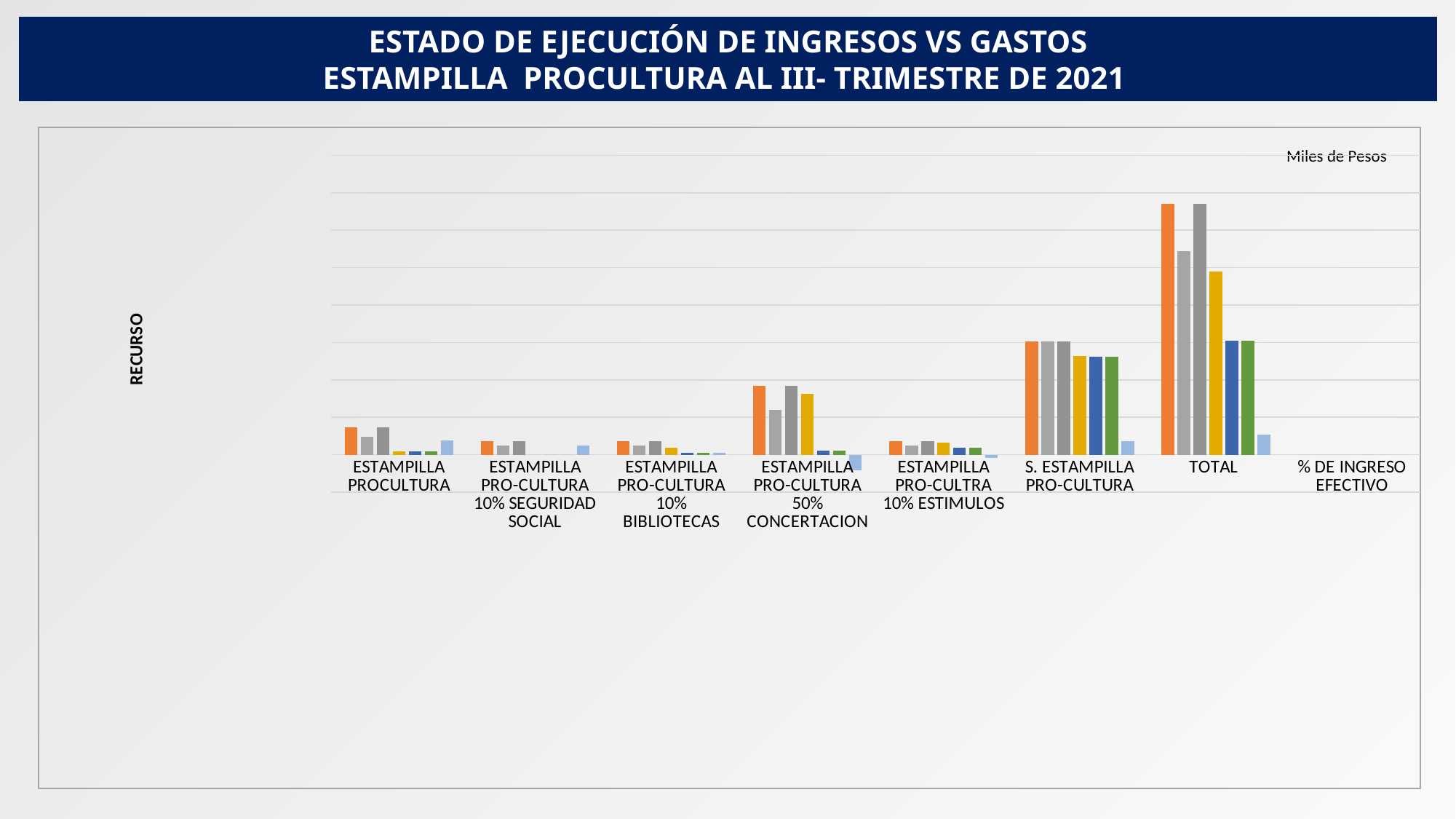
How many categories are shown along the x axis of the chart? 8 Which category has taller bars: TOTAL or ESTAMPILLA PROCULTURA? TOTAL Which category has taller bars: S. ESTAMPILLA PRO-CULTURA or ESTAMPILLA PRO-CULTURA 50% CONCERTACION? S. ESTAMPILLA PRO-CULTURA Which category has taller bars: ESTAMPILLA PRO-CULTURA 50% CONCERTACION or ESTAMPILLA PRO-CULTURA 10% BIBLIOTECAS? ESTAMPILLA PRO-CULTURA 50% CONCERTACION What unit is indicated in the top right corner of the chart? Miles de Pesos Which category has the tallest bars in the chart? TOTAL What kind of chart is shown on the slide? bar chart What is the label on the vertical axis of the chart? RECURSO